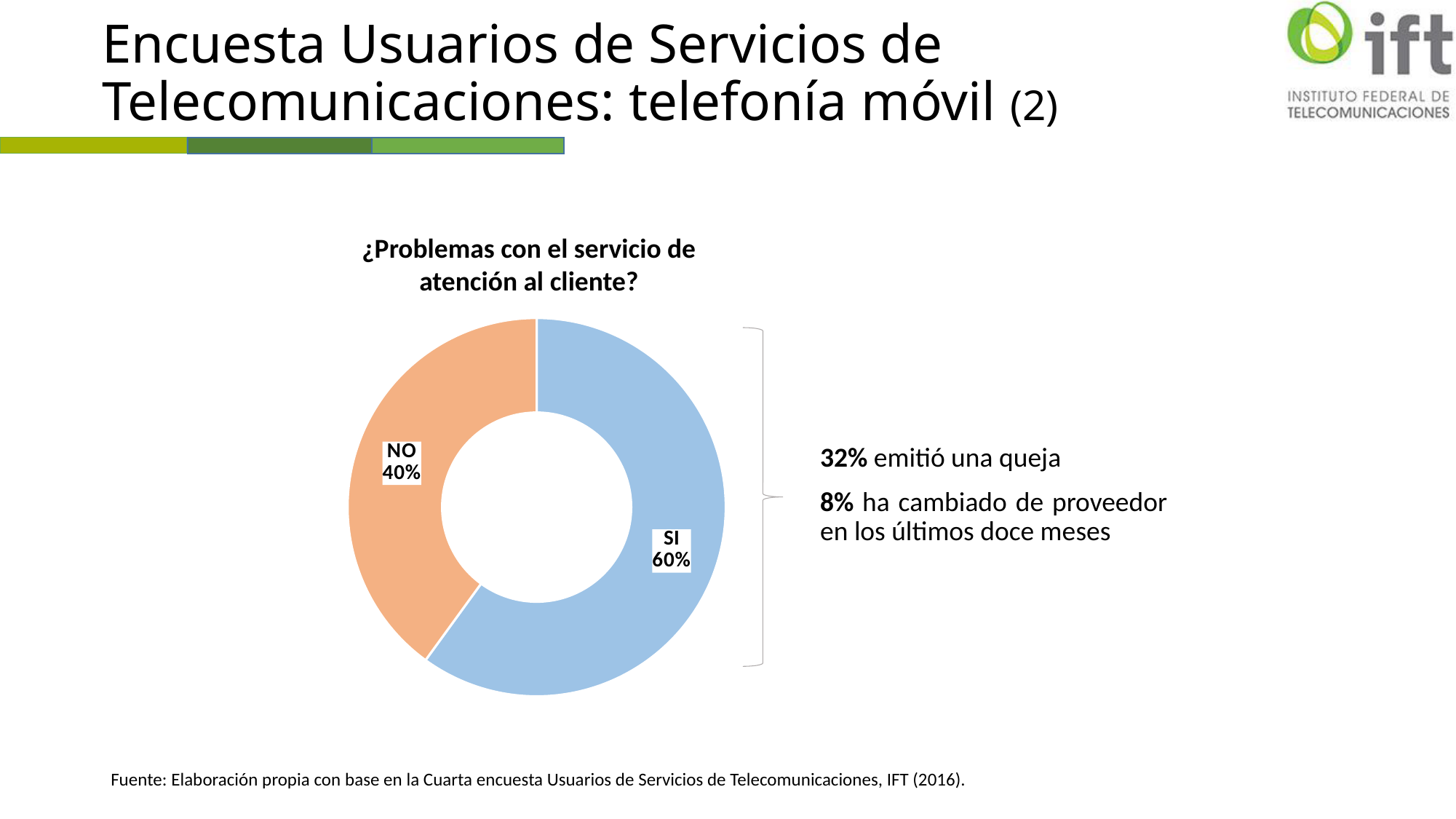
What colour is the SI slice of the chart? Blue What kind of chart is shown on the slide? Pie chart (doughnut) What percentage of respondents answered NO to the question about problems with customer service? 40% What share of the pie does the SI slice represent? 60% What is the title of the chart? ¿Problemas con el servicio de atención al cliente? Which is larger, the SI share or the NO share? SI What percentage of respondents answered SI to the question about problems with customer service? 60% How many categories are shown in the chart? 2 Which category has the smallest share of the chart? NO What is the difference in percentage points between the SI and NO shares? 20 Which category has the largest share of the chart? SI